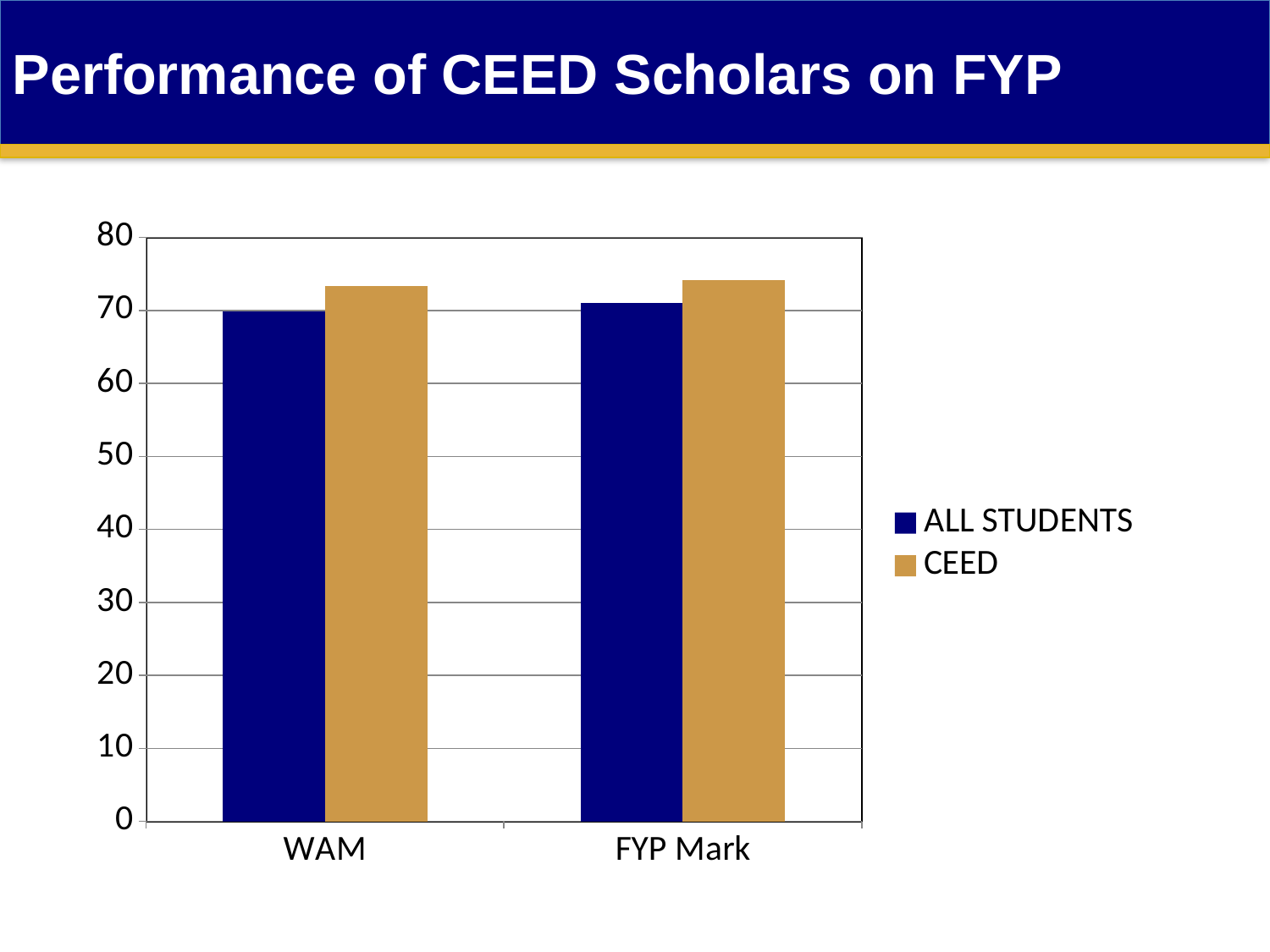
For FYP Mark, which series has the larger value, ALL STUDENTS or CEED? CEED How many series does the legend list? 2 What kind of chart is shown on the slide? bar chart Which series does the legend list first? ALL STUDENTS Is the CEED value for FYP Mark greater or less than 80? less What is the highest value shown on the y axis of the chart? 80 How many categories are shown on the x axis of the chart? 2 Is the ALL STUDENTS value for WAM greater or less than 60? greater For WAM, which series has the larger value, ALL STUDENTS or CEED? CEED What is the title of the slide containing the chart? Performance of CEED Scholars on FYP Is the ALL STUDENTS value for FYP Mark greater or less than 80? less